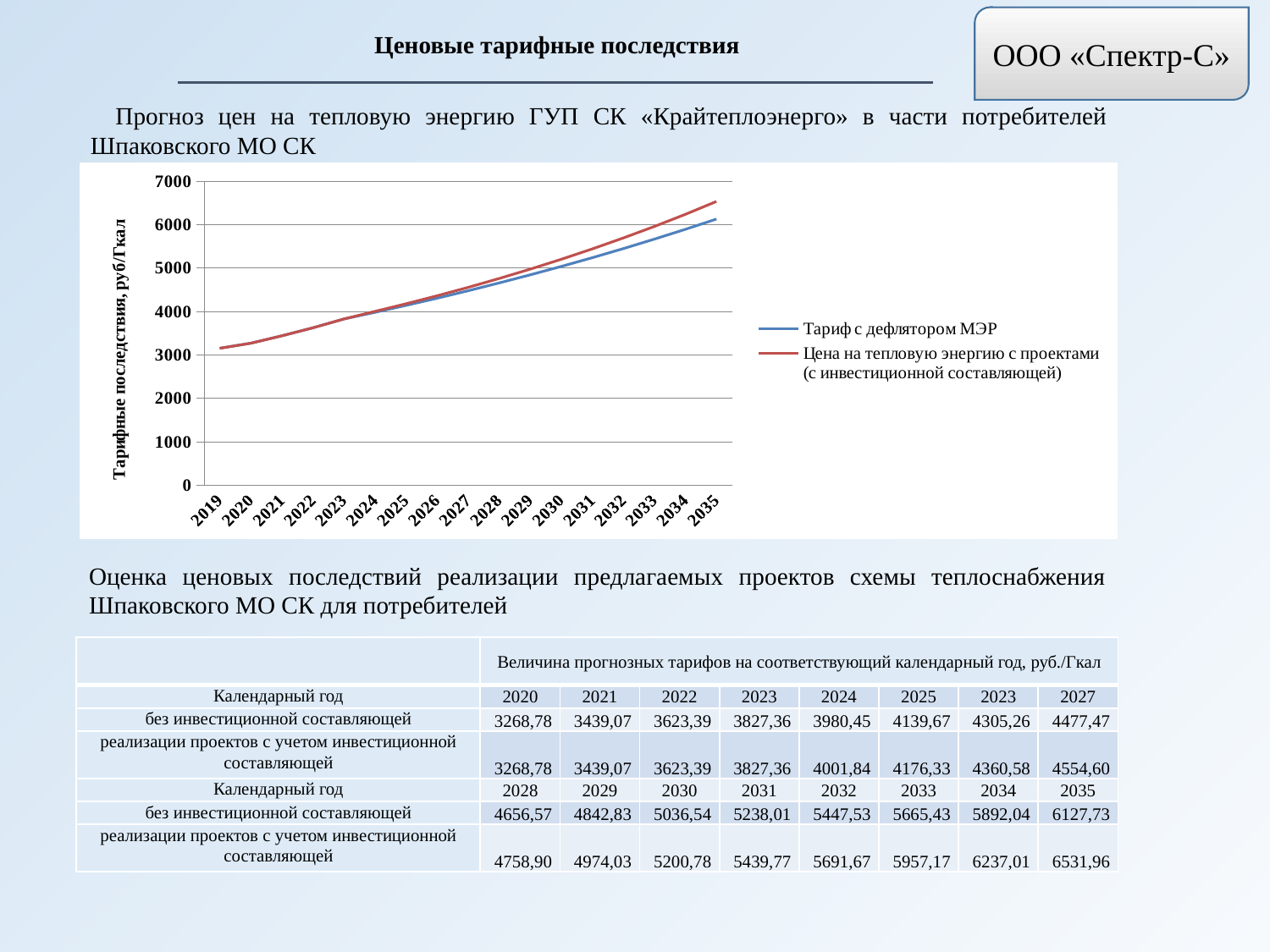
What is the title of the vertical axis of the chart? Тарифные последствия, руб/Гкал What colour is the line for "Тариф с дефлятором МЭР" in the chart? blue Do the values of the series "Тариф с дефлятором МЭР" rise or fall from 2019 to 2035? rise Is the value for "Тариф с дефлятором МЭР" in 2019 greater or less than 4000? less What kind of chart is shown on the slide? line chart Is the value for "Цена на тепловую энергию с проектами (с инвестиционной составляющей)" in 2027 greater or less than 4000? greater Is the value for "Цена на тепловую энергию с проектами (с инвестиционной составляющей)" in 2035 greater or less than 6000? greater How many years are shown along the x axis of the chart? 17 In 2035, which series has the higher value: "Тариф с дефлятором МЭР" or "Цена на тепловую энергию с проектами (с инвестиционной составляющей)"? Цена на тепловую энергию с проектами (с инвестиционной составляющей) Do the values of the series "Цена на тепловую энергию с проектами (с инвестиционной составляющей)" rise or fall along the x axis? rise How many series does the chart legend list? 2